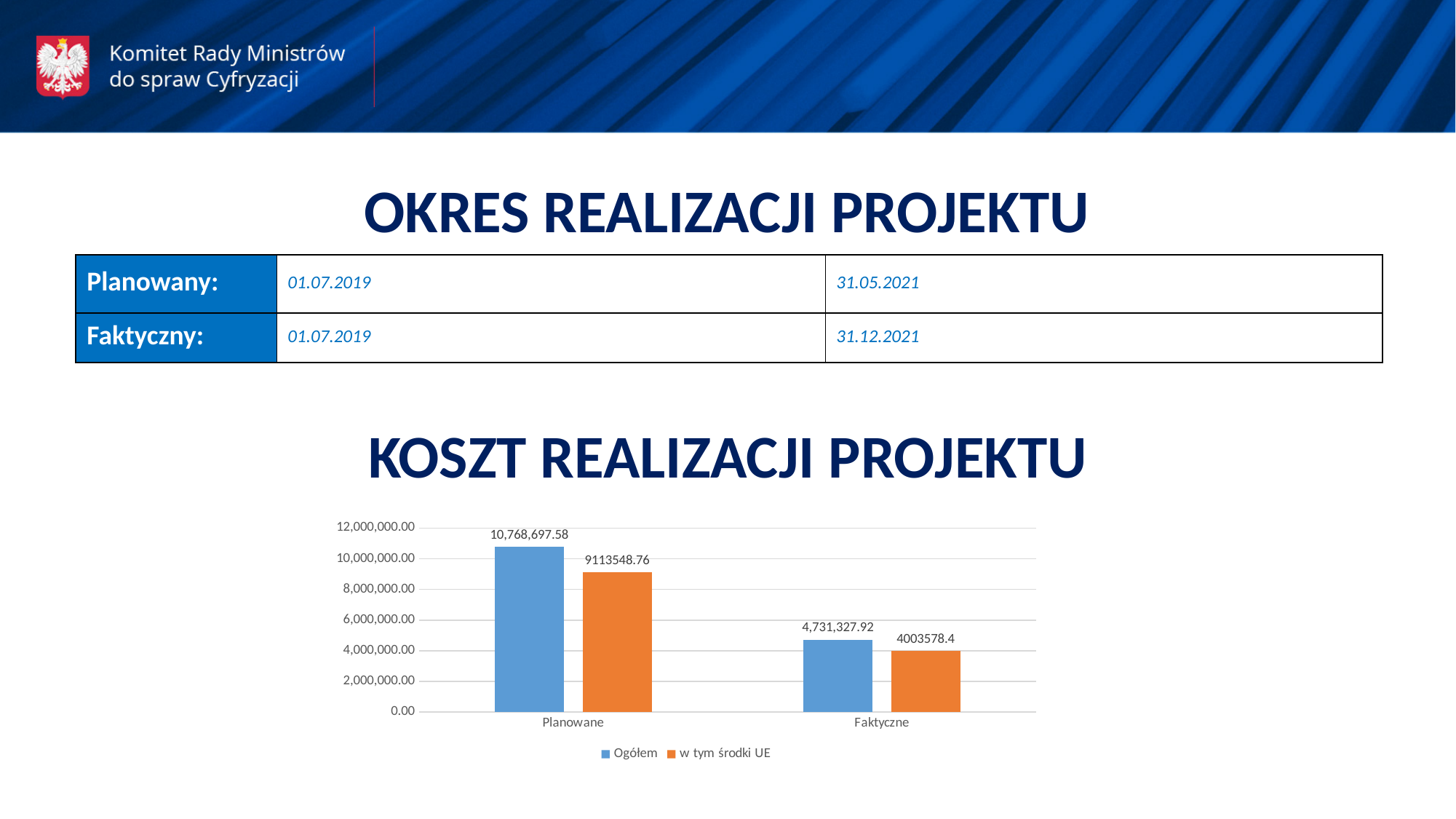
What type of chart is shown under "KOSZT REALIZACJI PROJEKTU"? Bar chart What is the value of w tym środki UE for Planowane? 9113548.76 What is the value of Ogółem for Planowane? 10,768,697.58 What is the value of Ogółem for Faktyczne? 4,731,327.92 Which bar in the chart has the lowest value? w tym środki UE for Faktyczne What is the difference between Ogółem and w tym środki UE for Faktyczne? 727,749.52 How many categories are shown on the x axis of the chart? 2 Which bar in the chart has the highest value? Ogółem for Planowane How many series does the chart legend list? 2 Which is larger: w tym środki UE for Planowane or Ogółem for Faktyczne? w tym środki UE for Planowane What is the value of w tym środki UE for Faktyczne? 4003578.4 What is the difference between Ogółem for Planowane and Ogółem for Faktyczne? 6,037,369.66